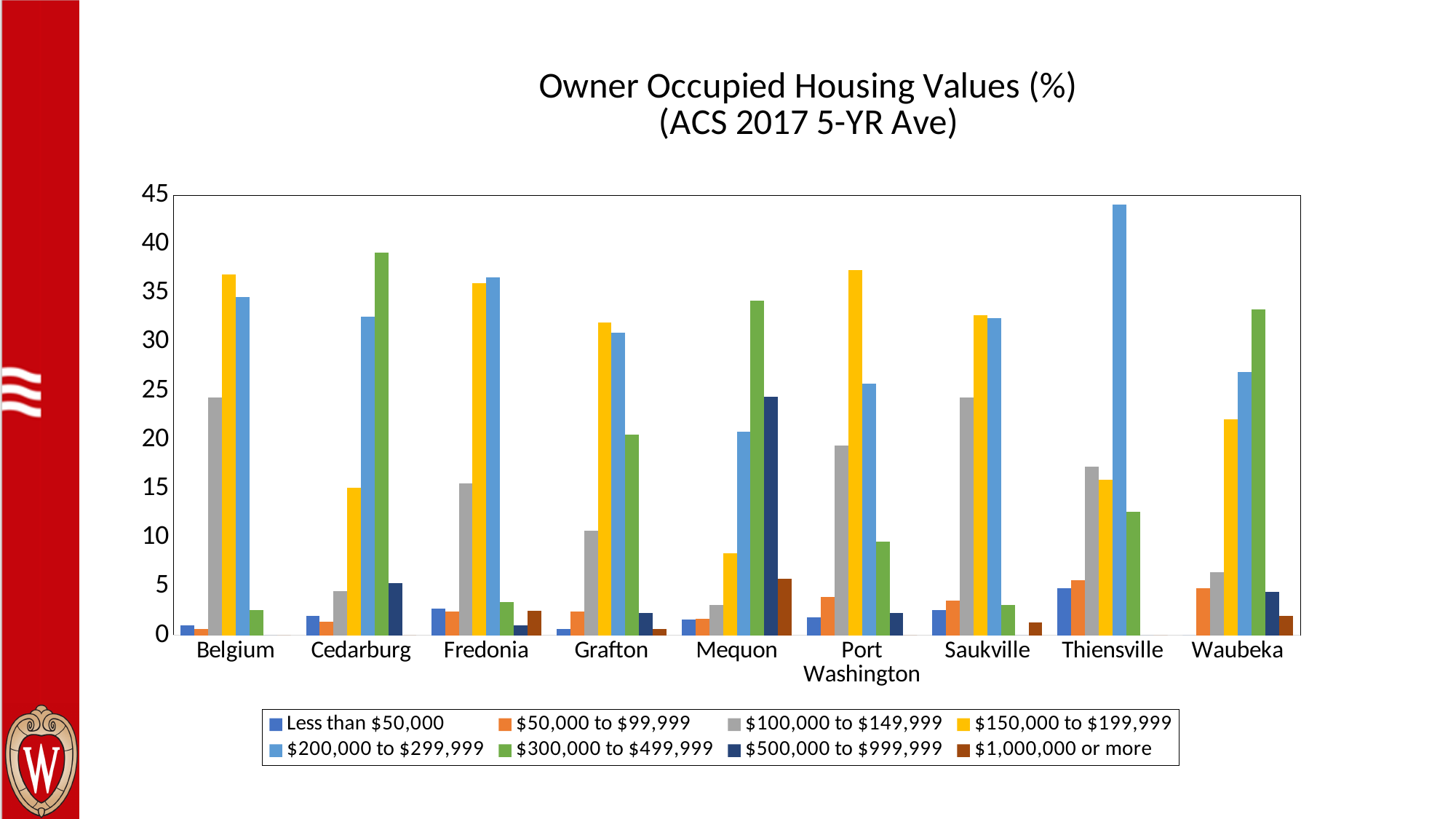
Which municipality has the highest value for the $500,000 to $999,999 series? Mequon What kind of chart is shown on the slide? Bar chart Is the value for Waubeka in the $300,000 to $499,999 series greater or less than 30? greater How many municipalities are shown on the x axis of the chart? 9 How many series does the legend list? 8 Which municipality has the highest value for the $200,000 to $299,999 series? Thiensville What is the title of the chart? Owner Occupied Housing Values (%) (ACS 2017 5-YR Ave) Is the value for Mequon in the $500,000 to $999,999 series greater or less than 20? greater Is the value for Port Washington in the $150,000 to $199,999 series greater or less than 35? greater For Cedarburg, which is larger: the $300,000 to $499,999 value or the $200,000 to $299,999 value? $300,000 to $499,999 Which municipality has the highest value for the $300,000 to $499,999 series? Cedarburg